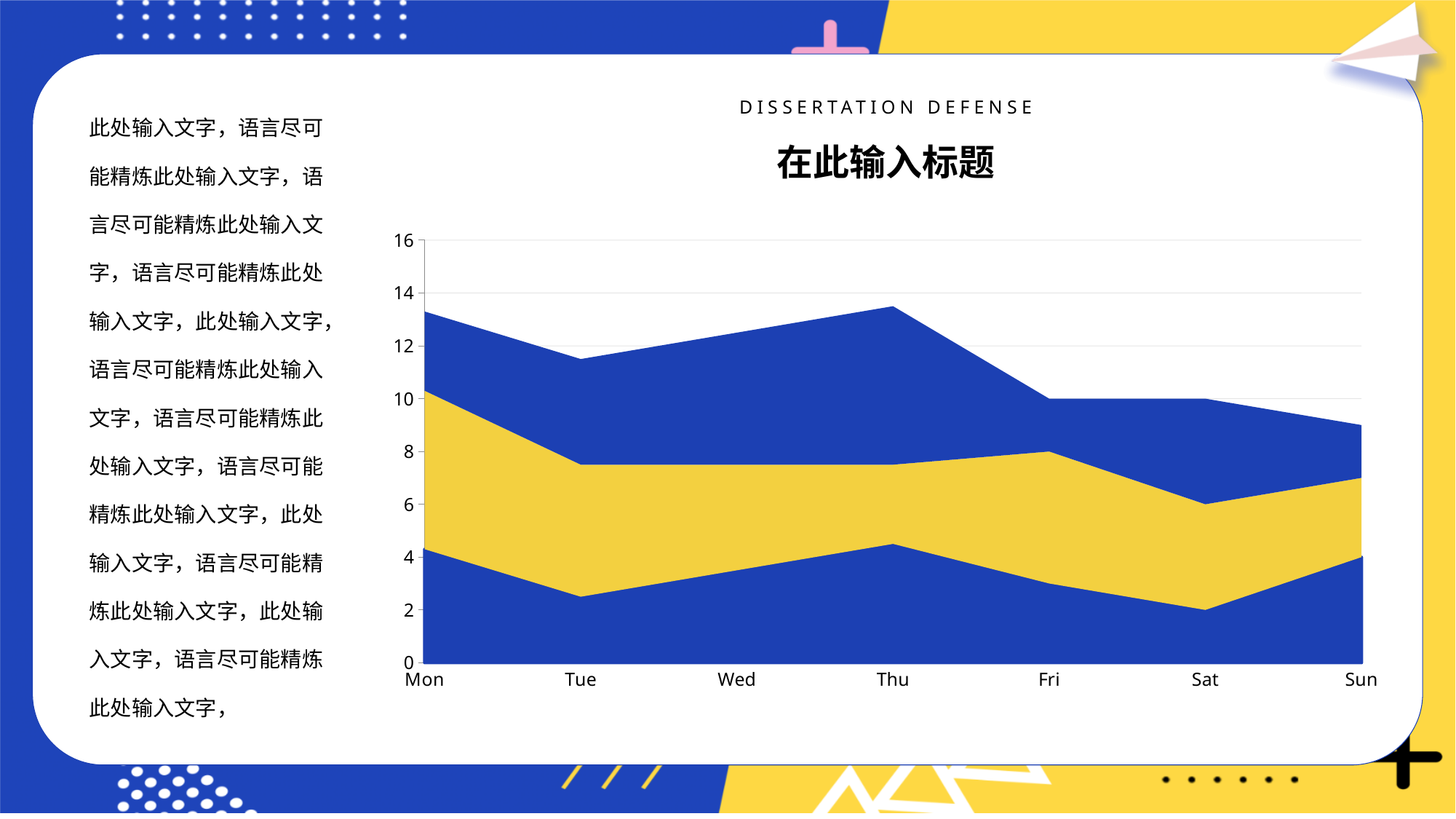
What is the title of the chart on the slide? 在此输入标题 Is the stacked total on Tue greater or less than 12? less What is the stacked total (top of the upper band) on Sat? 10 On which day is the bottom (blue) series lowest? Sat On which day is the stacked total lowest? Sun How many categories are shown on the x axis of the chart? 7 What is the value of the bottom (blue) series on Sat? 2 How many stacked bands (series) are plotted in the chart? 3 What is the value of the bottom (blue) series on Sun? 4 Does the stacked total rise or fall from Thu to Sun? fall What is the stacked total (top of the upper band) on Fri? 10 What kind of chart is shown on the slide? Stacked area chart